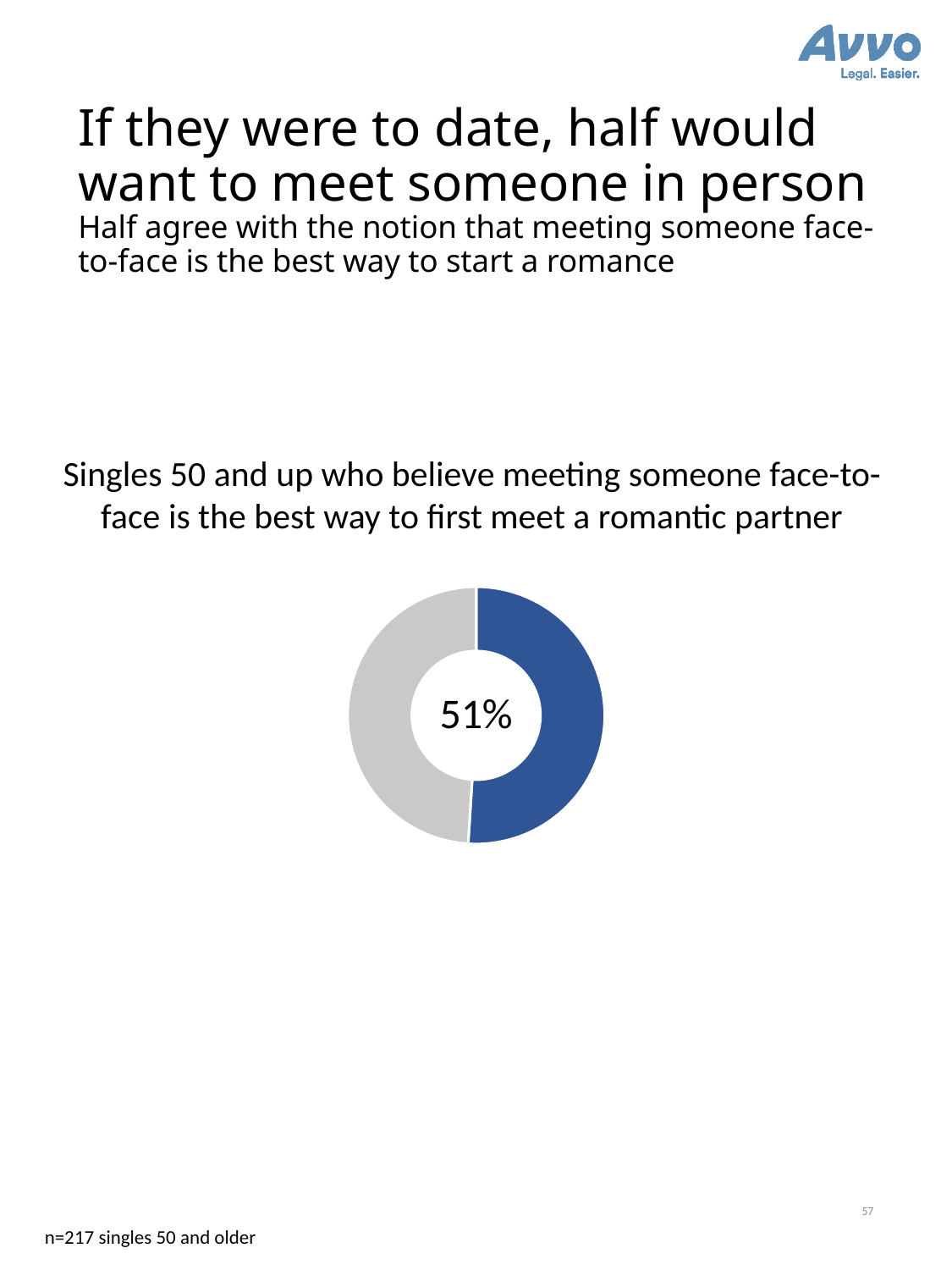
Is the value shown in the centre of the donut chart greater or less than 50%? greater What is the title of the chart on the slide? Singles 50 and up who believe meeting someone face-to-face is the best way to first meet a romantic partner What share of the donut chart does the grey segment represent? 49% What kind of chart is shown on the slide? Donut (pie) chart How many segments does the donut chart have? 2 What colour is the segment of the donut chart that represents the 51% value? Blue What percentage of singles 50 and up believe meeting someone face-to-face is the best way to first meet a romantic partner, according to the chart? 51% What share of the donut chart does the blue segment represent? 51% Which segment of the donut chart is larger, the blue one or the grey one? The blue one